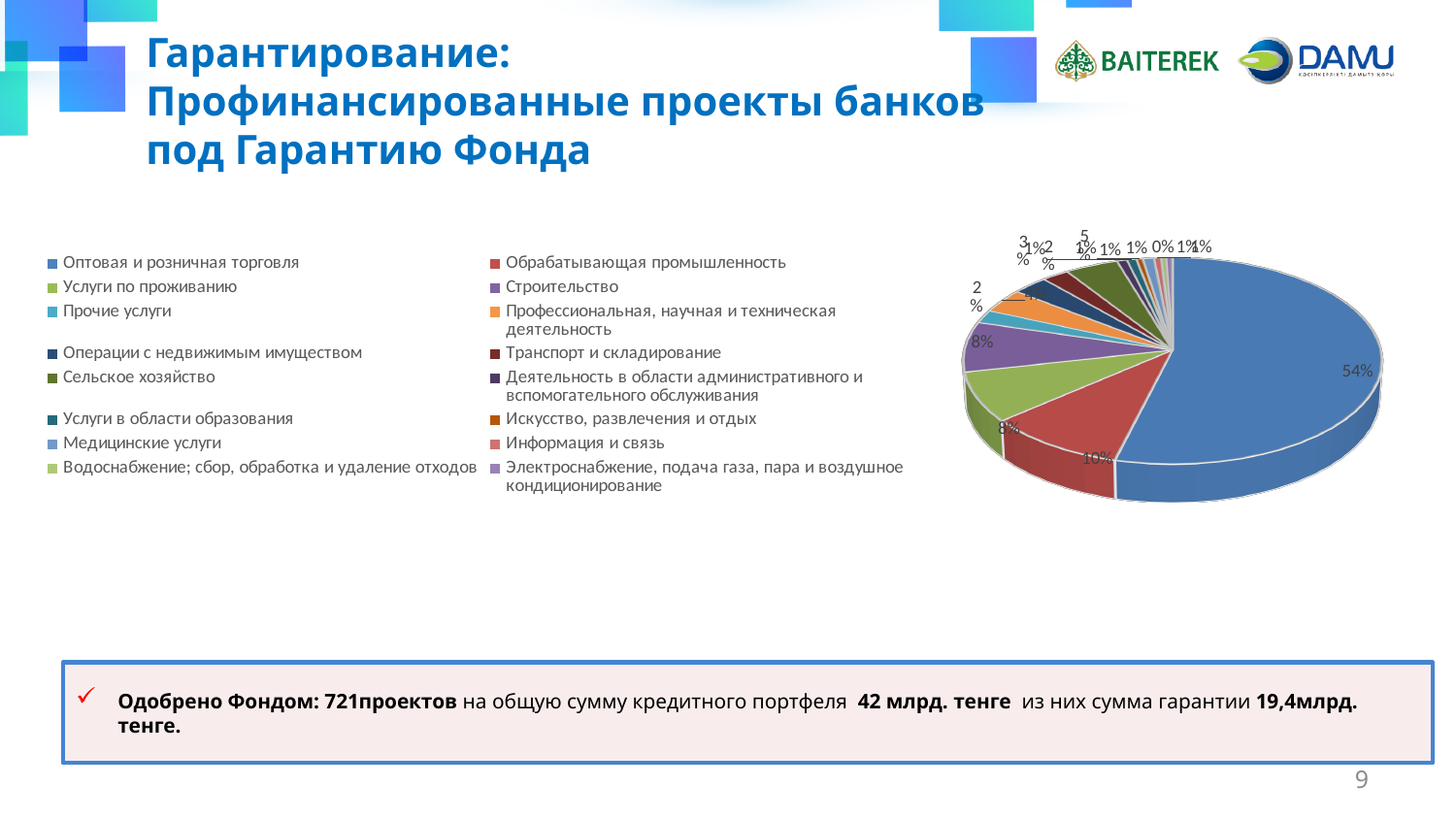
Which is larger: the slice for Оптовая и розничная торговля or the slice for Обрабатывающая промышленность? Оптовая и розничная торговля Which category has the largest slice of the pie? Оптовая и розничная торговля What share of the pie does Оптовая и розничная торговля hold? 54% What kind of chart is shown on the slide? pie chart How many categories does the legend list? 16 What is the value shown for Обрабатывающая промышленность? 10% What is the value shown for Строительство? 8% What is the difference in percentage points between Обрабатывающая промышленность (10%) and Услуги по проживанию (8%)? 2 percentage points Which legend entry is listed first? Оптовая и розничная торговля What is the difference in percentage points between Оптовая и розничная торговля (54%) and Обрабатывающая промышленность (10%)? 44 percentage points What colour is the largest slice of the pie? blue What is the value shown for Услуги по проживанию? 8%